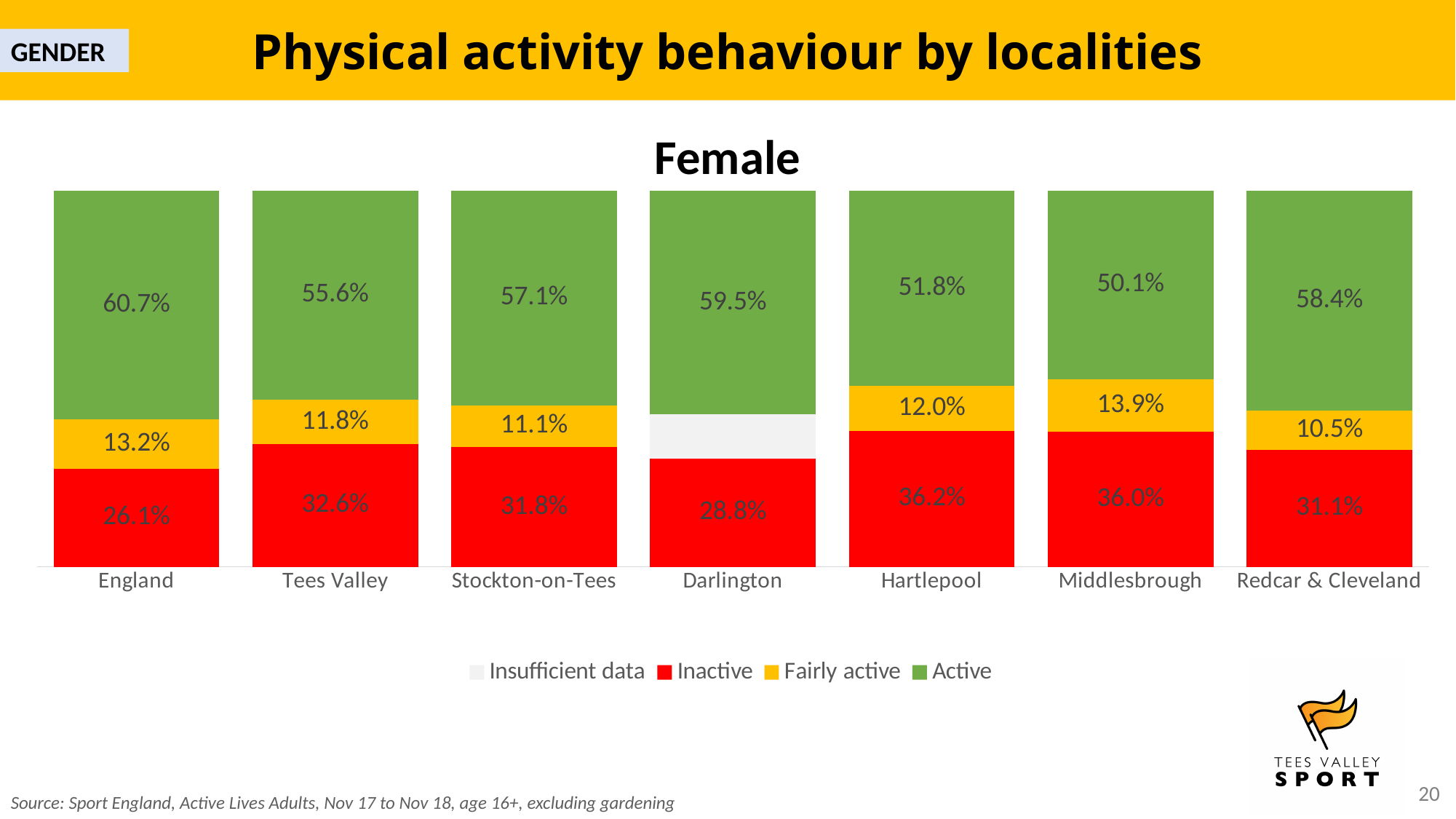
What kind of chart is shown? Stacked bar chart What is the Inactive percentage for Darlington? 28.8% What is the Fairly active percentage for Middlesbrough? 13.9% Which has a higher Active percentage, Stockton-on-Tees or Tees Valley? Stockton-on-Tees How many series does the legend list? 4 Which locality has the lowest Active percentage? Middlesbrough What is the Inactive percentage for Hartlepool? 36.2% Which locality has the highest Active percentage? England Which locality has the lowest Fairly active percentage? Redcar & Cleveland What is the Active percentage for England? 60.7% What is the difference in Active percentage between England and Middlesbrough? 10.6 percentage points How many localities are shown on the x axis? 7